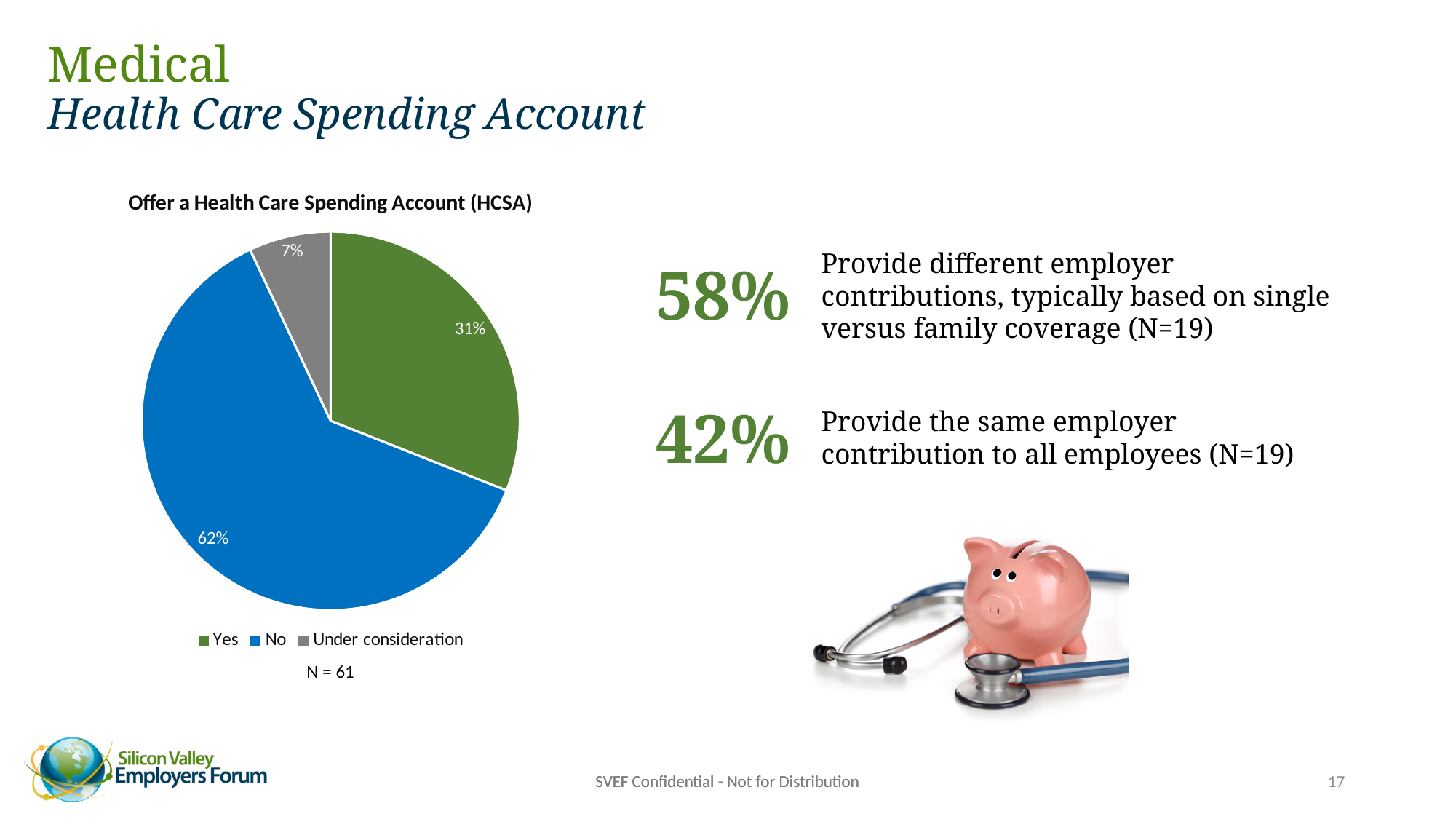
Which category has the smallest slice of the pie chart? Under consideration What percentage of respondents answered "No" to offering a Health Care Spending Account? 62% What colour is the "No" slice in the pie chart? Blue How many categories does the pie chart show? 3 Which category has the largest slice of the pie chart? No Which is larger, the "Yes" slice or the "Under consideration" slice? Yes What kind of chart is shown on the slide? Pie chart What is the sample size (N) shown below the pie chart? N = 61 What is the title of the pie chart? Offer a Health Care Spending Account (HCSA) What percentage of respondents have a Health Care Spending Account "Under consideration"? 7% What is the difference in percentage points between the "No" and "Yes" slices? 31 What percentage of respondents answered "Yes" to offering a Health Care Spending Account? 31%